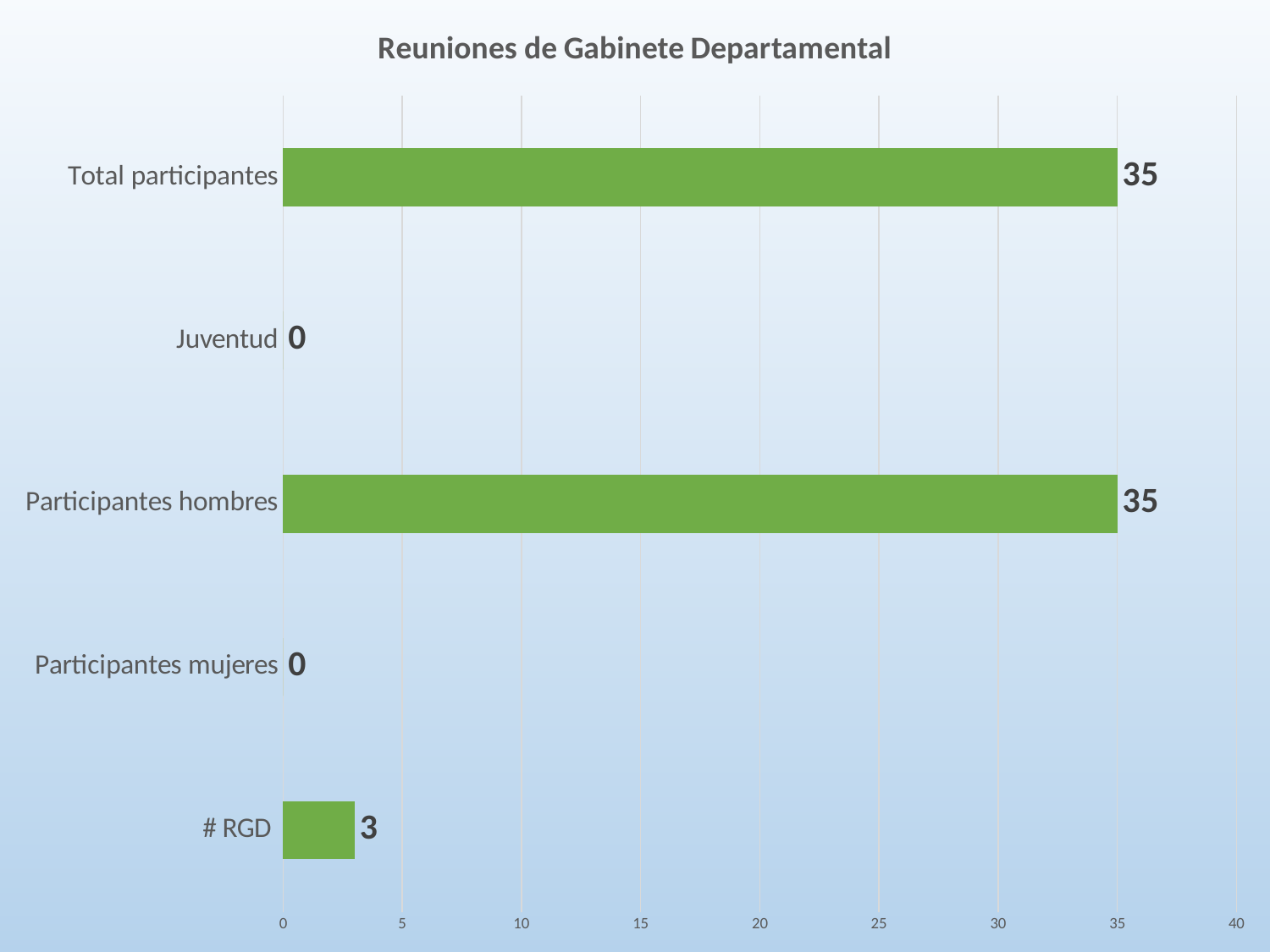
Which is larger, Participantes hombres or Participantes mujeres? Participantes hombres What is the value for Participantes hombres? 35 Is the value for Total participantes greater or less than 30? greater What is the value for Total participantes? 35 What is the difference between Total participantes and Participantes hombres? 0 What is the value for Juventud? 0 How many categories are shown on the chart? 5 What is the value for Participantes mujeres? 0 What kind of chart is this? bar chart What is the difference between Participantes hombres and # RGD? 32 What is the title of the chart? Reuniones de Gabinete Departamental What is the value for # RGD? 3